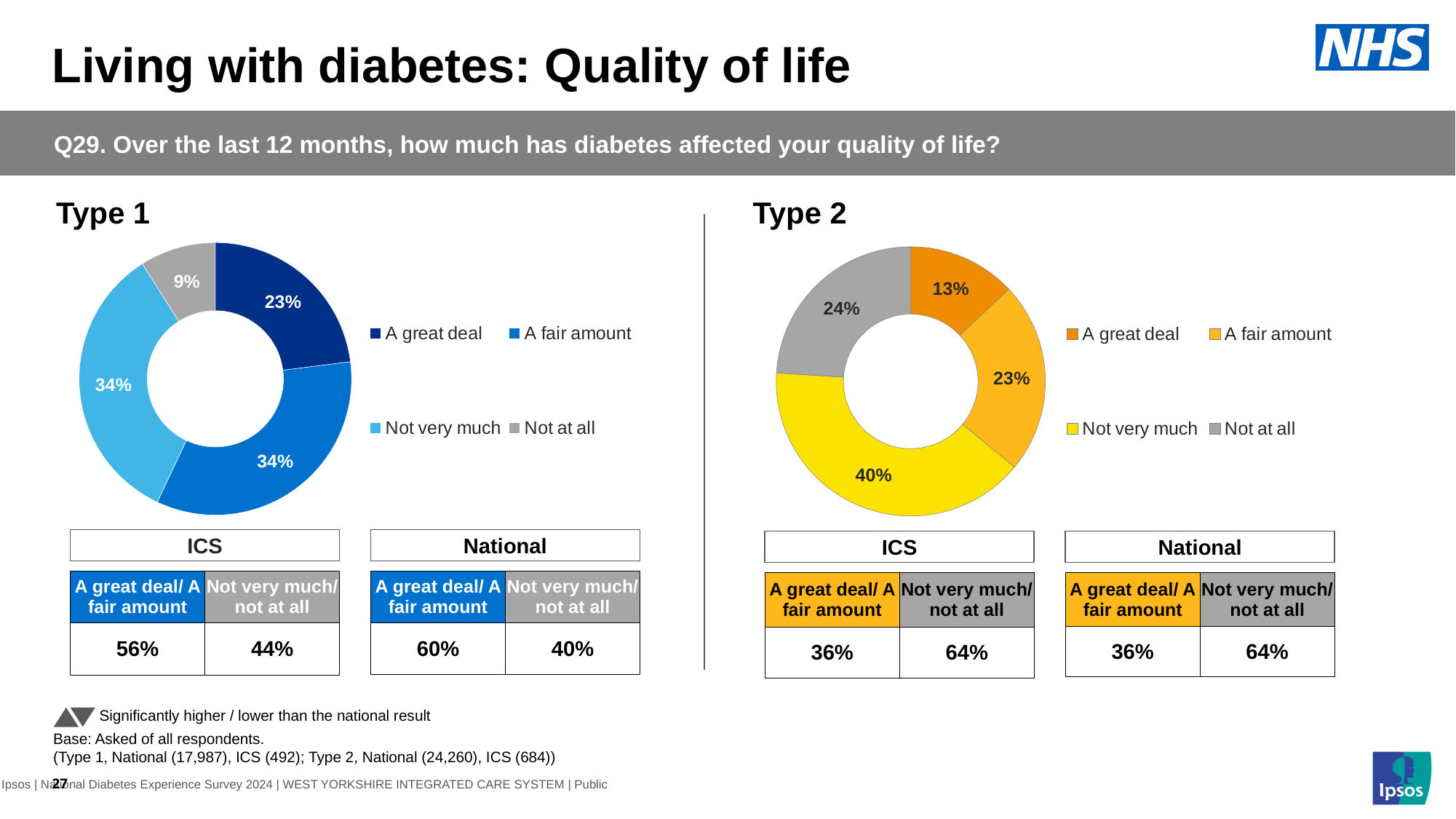
In the Type 2 chart, what is the difference in percentage points between 'Not very much' and 'Not at all'? 16 How many categories does the legend of the Type 2 chart list? 4 In the Type 2 chart, which category has the largest share? Not very much In the Type 1 chart, what percentage is shown for 'Not at all'? 9% In the Type 1 chart, what percentage of respondents said diabetes affected their quality of life 'A great deal'? 23% In the Type 2 chart, what percentage is shown for 'A fair amount'? 23% Is the share for 'A great deal' larger in the Type 1 chart or the Type 2 chart? Type 1 In the Type 1 chart, what is the difference in percentage points between 'A fair amount' and 'A great deal'? 11 In the Type 2 chart, what percentage is shown for 'Not very much'? 40% What kind of chart is used to show the Type 1 results? Donut (pie) chart In the Type 2 chart, which category has the smallest share? A great deal In the Type 1 chart, which category has the smallest share? Not at all